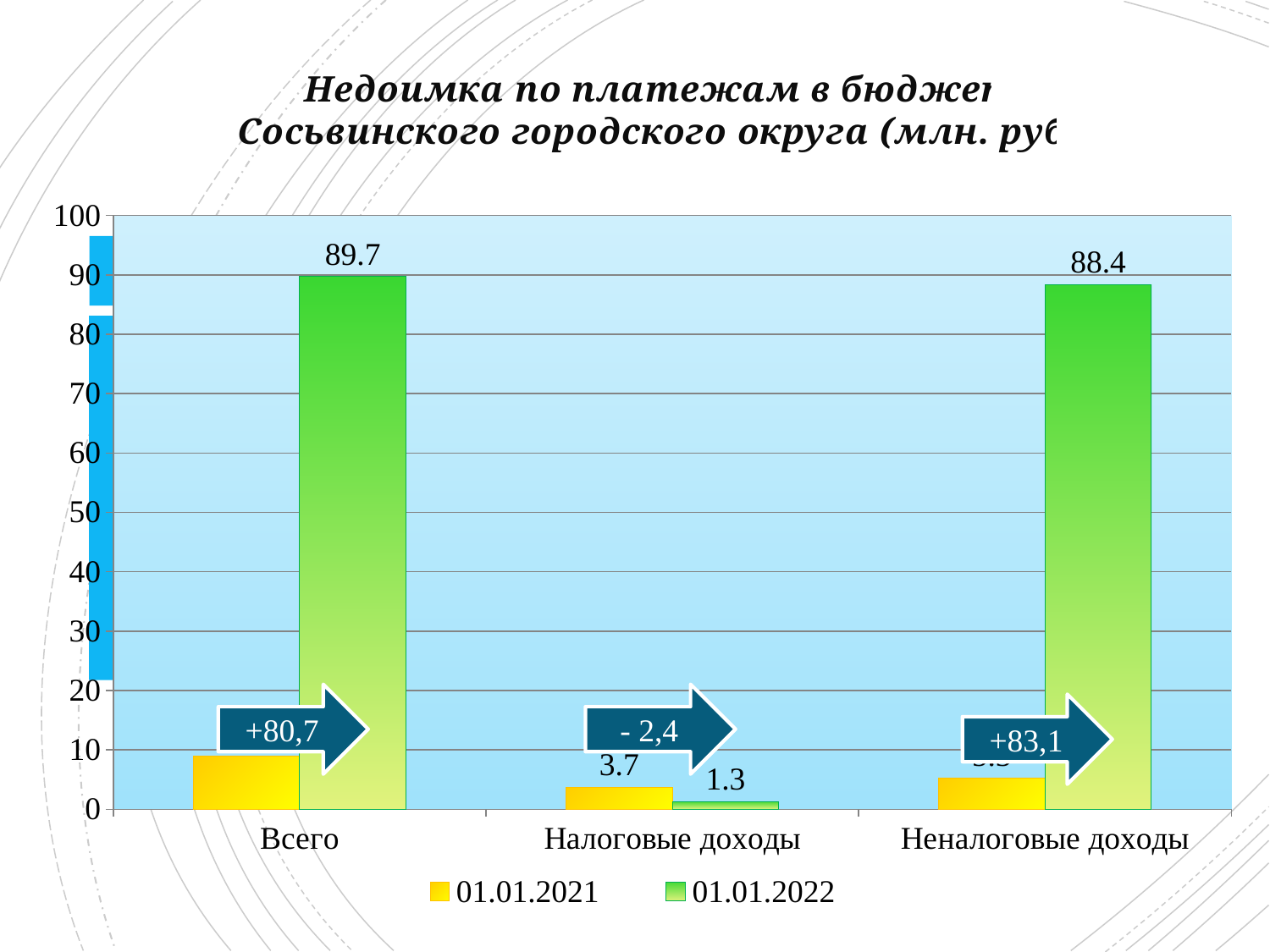
For Налоговые доходы, which is larger: the 01.01.2021 value or the 01.01.2022 value? 01.01.2021 What is the value for Всего on 01.01.2022? 89.7 How many series does the legend list? 2 Which category has the highest value for the 01.01.2022 series? Всего What is the value for Налоговые доходы on 01.01.2022? 1.3 How many categories are shown on the x axis? 3 Is the value for Всего on 01.01.2021 greater or less than 20? less Which category has the lowest value for the 01.01.2022 series? Налоговые доходы What kind of chart is shown on the slide? bar chart What is the value for Неналоговые доходы on 01.01.2022? 88.4 What is the difference between the 01.01.2021 and 01.01.2022 values for Налоговые доходы? 2.4 What is the value for Налоговые доходы on 01.01.2021? 3.7